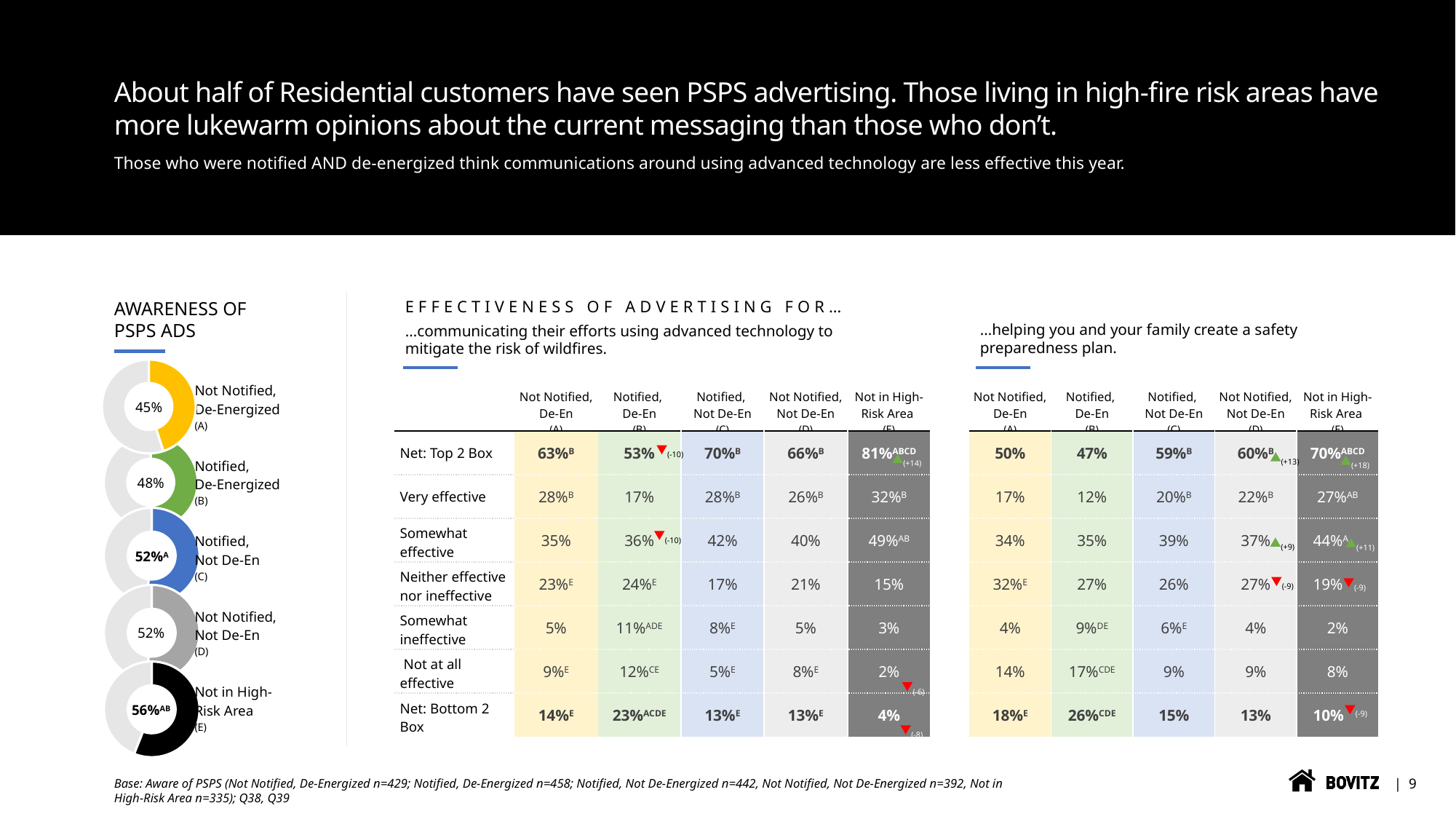
Among the Awareness of PSPS Ads donut charts, which group has the lowest awareness? Not Notified, De-Energized In the Awareness of PSPS Ads donut charts, what is the difference in percentage points between the Not in High-Risk Area group and the Not Notified, De-Energized group? 11 percentage points In the Awareness of PSPS Ads donut charts, what percentage is shown for the Notified, Not De-En group? 52% In the Awareness of PSPS Ads donut charts, what percentage is shown for the Notified, De-Energized group? 48% What kind of chart is used to show Awareness of PSPS Ads? Donut (pie) chart Among the Awareness of PSPS Ads donut charts, which group has the highest awareness? Not in High-Risk Area In the Awareness of PSPS Ads donut charts, what colour is used for the Not in High-Risk Area group? Black In the Awareness of PSPS Ads donut charts, what percentage is shown for the Not in High-Risk Area group? 56% In the Awareness of PSPS Ads donut charts, is the value for Not Notified, De-Energized greater or less than 50%? less In the Awareness of PSPS Ads donut charts, what percentage is shown for the Not Notified, De-Energized group? 45% In the Awareness of PSPS Ads donut charts, which is larger: the value for Notified, De-Energized or the value for Not in High-Risk Area? Not in High-Risk Area How many donut charts are shown under Awareness of PSPS Ads? 5